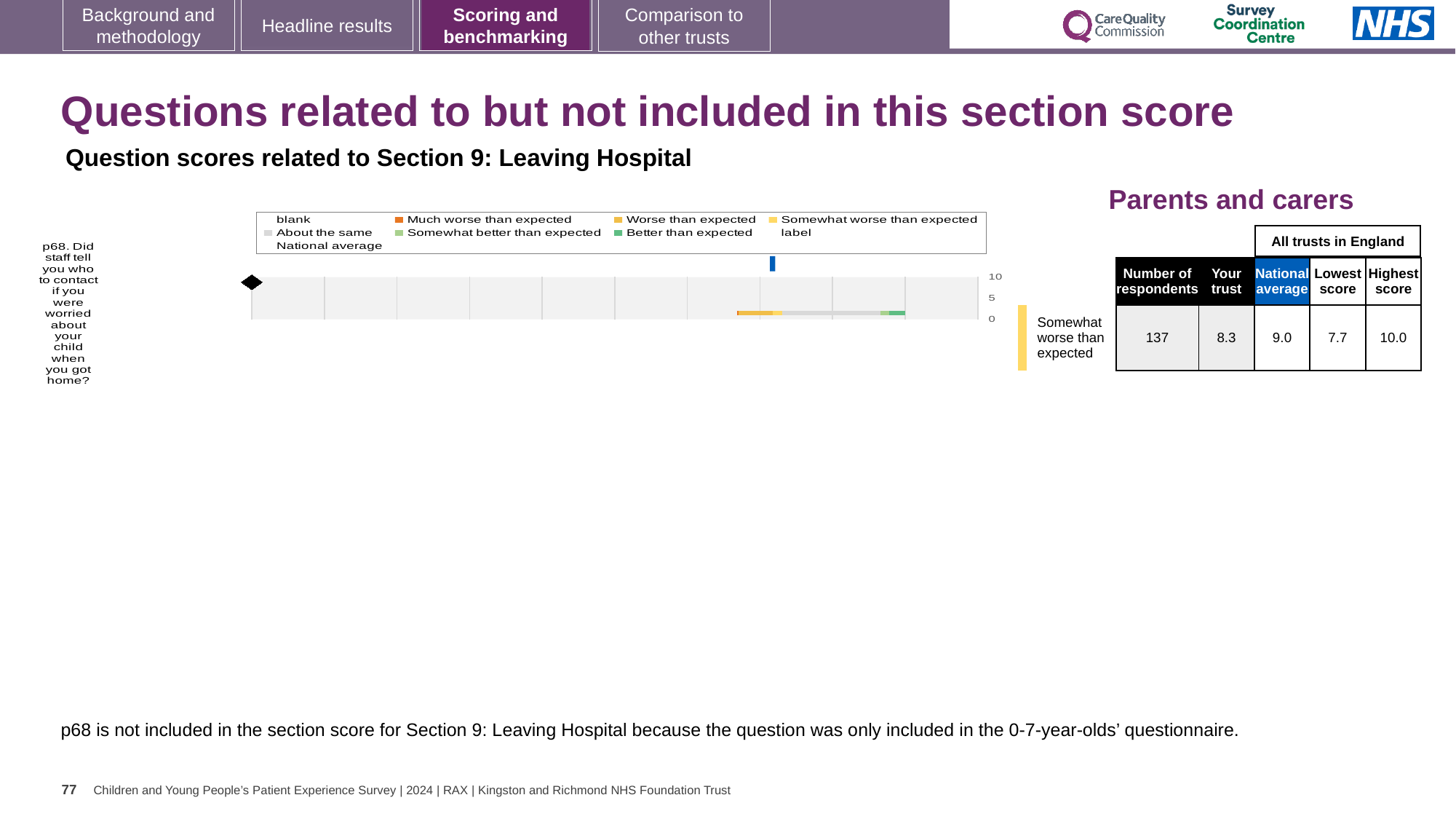
How many entries does the chart legend list? 9 What is the 'Your trust' score for p68 in the Parents and carers table? 8.3 What is the National average score for p68 in the Parents and carers table? 9.0 What is the Highest score across all trusts in England for p68? 10.0 Which legend entry is shown in dark green? Better than expected What is the Lowest score across all trusts in England for p68? 7.7 What kind of chart is shown for question p68? bar chart What is the difference between the Highest score and the Lowest score for p68? 2.3 How many questions are plotted in the chart? 1 How many respondents answered p68 in the Parents and carers table? 137 Which legend entry is shown in dark orange? Much worse than expected Which is larger for p68: the Your trust score or the National average? National average